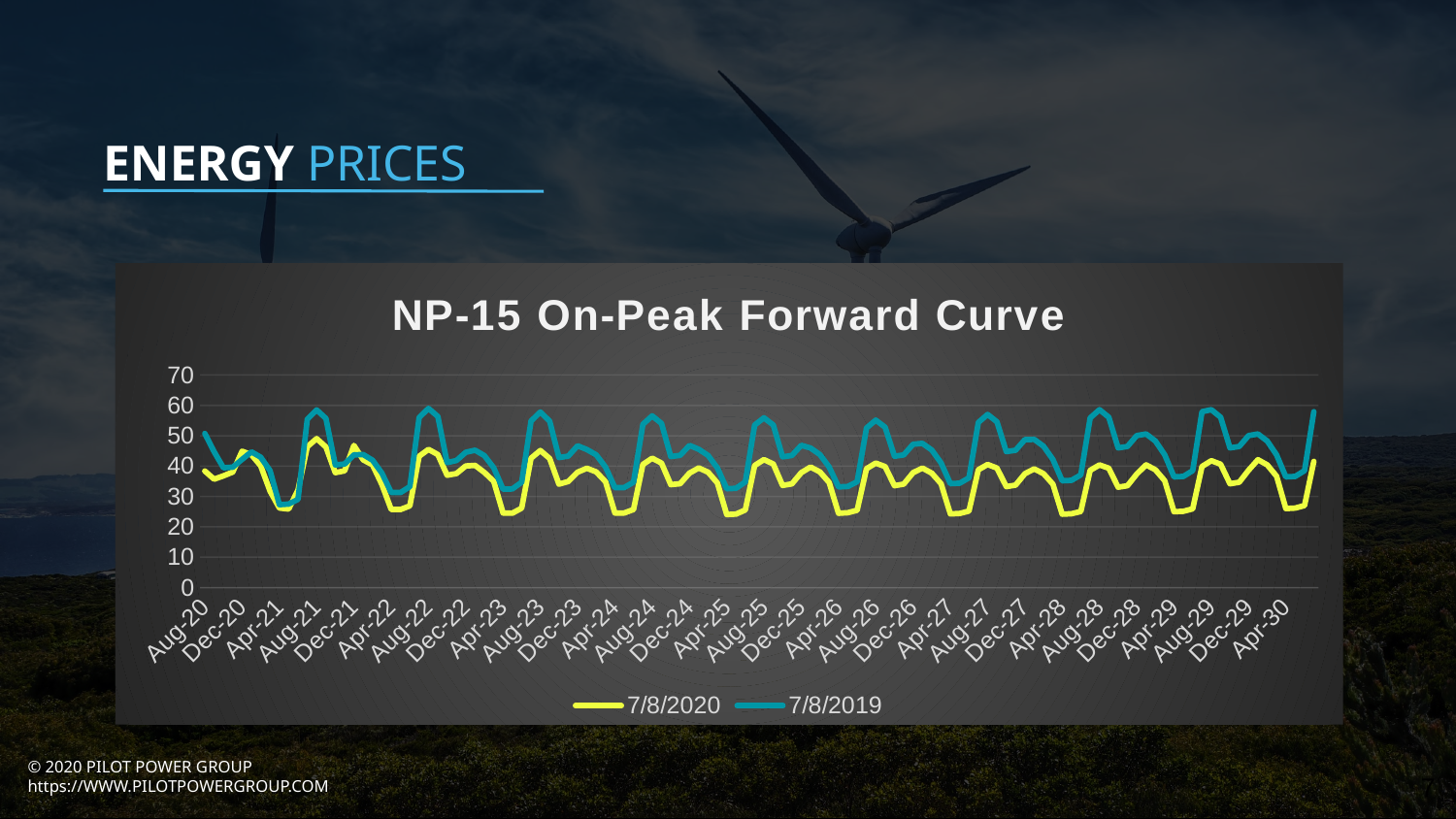
How many series does the legend of the NP-15 On-Peak Forward Curve chart list? 2 At Apr-30, which series has the higher value, 7/8/2020 or 7/8/2019? 7/8/2019 What is the title of the chart on the slide? NP-15 On-Peak Forward Curve Is the lowest value reached by the 7/8/2020 series greater or less than 30? less Which series is drawn in yellow on the chart? 7/8/2020 Which series sits higher across most of the chart, 7/8/2020 or 7/8/2019? 7/8/2019 Is the value of the 7/8/2019 series at Apr-30 greater or less than 50? less Is the highest value reached by the 7/8/2020 series greater or less than 60? less What type of chart is the NP-15 On-Peak Forward Curve? Line chart